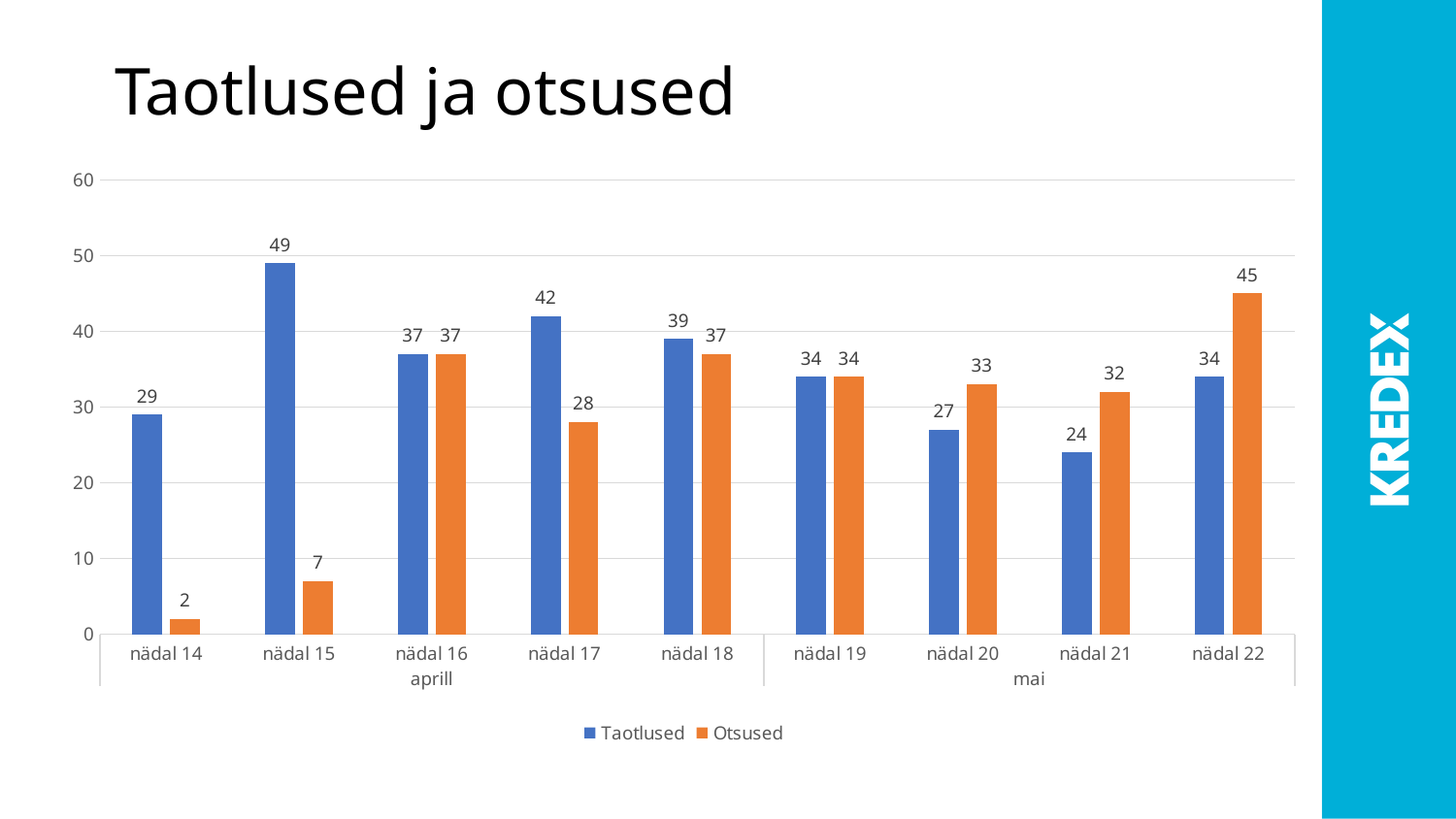
What is the difference between Taotlused and Otsused for nädal 17? 14 Which is larger for nädal 21, Taotlused or Otsused? Otsused Which week has the highest Taotlused value? nädal 15 What kind of chart is shown on the slide? Bar chart What is the title of the chart? Taotlused ja otsused Which colour represents the Otsused series? Orange What is the value of Taotlused for nädal 15? 49 What is the value of Otsused for nädal 14? 2 What is the value of Otsused for nädal 22? 45 How many weeks are shown on the x axis? 9 Which week has the lowest Otsused value? nädal 14 How many series does the legend list? 2